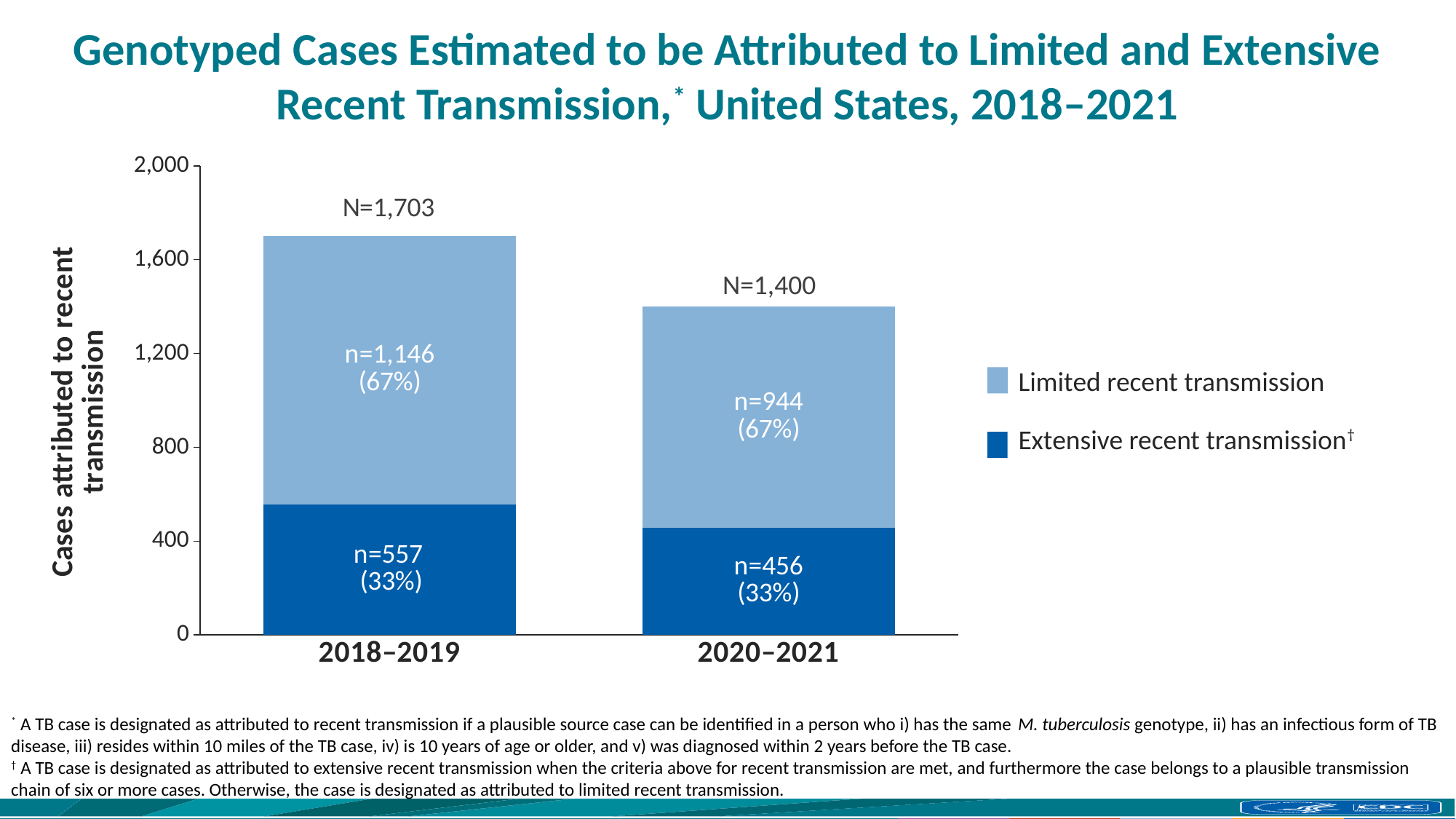
What percentage of cases in 2020–2021 were attributed to limited recent transmission? 67% What is the difference in extensive recent transmission cases between 2018–2019 and 2020–2021? 101 How many cases were attributed to limited recent transmission in 2018–2019? n=1,146 Which period has the higher total number of cases attributed to recent transmission? 2018–2019 How many time periods are shown on the x axis? 2 Is the total for 2020–2021 greater or less than 1,600? less What is the total number of genotyped cases attributed to recent transmission for 2020–2021? N=1,400 What is the total number of genotyped cases attributed to recent transmission for 2018–2019? N=1,703 How many cases were attributed to extensive recent transmission in 2020–2021? n=456 What kind of chart is shown on the slide? Stacked bar chart What is the difference in total cases between 2018–2019 and 2020–2021? 303 How many series does the legend list? 2